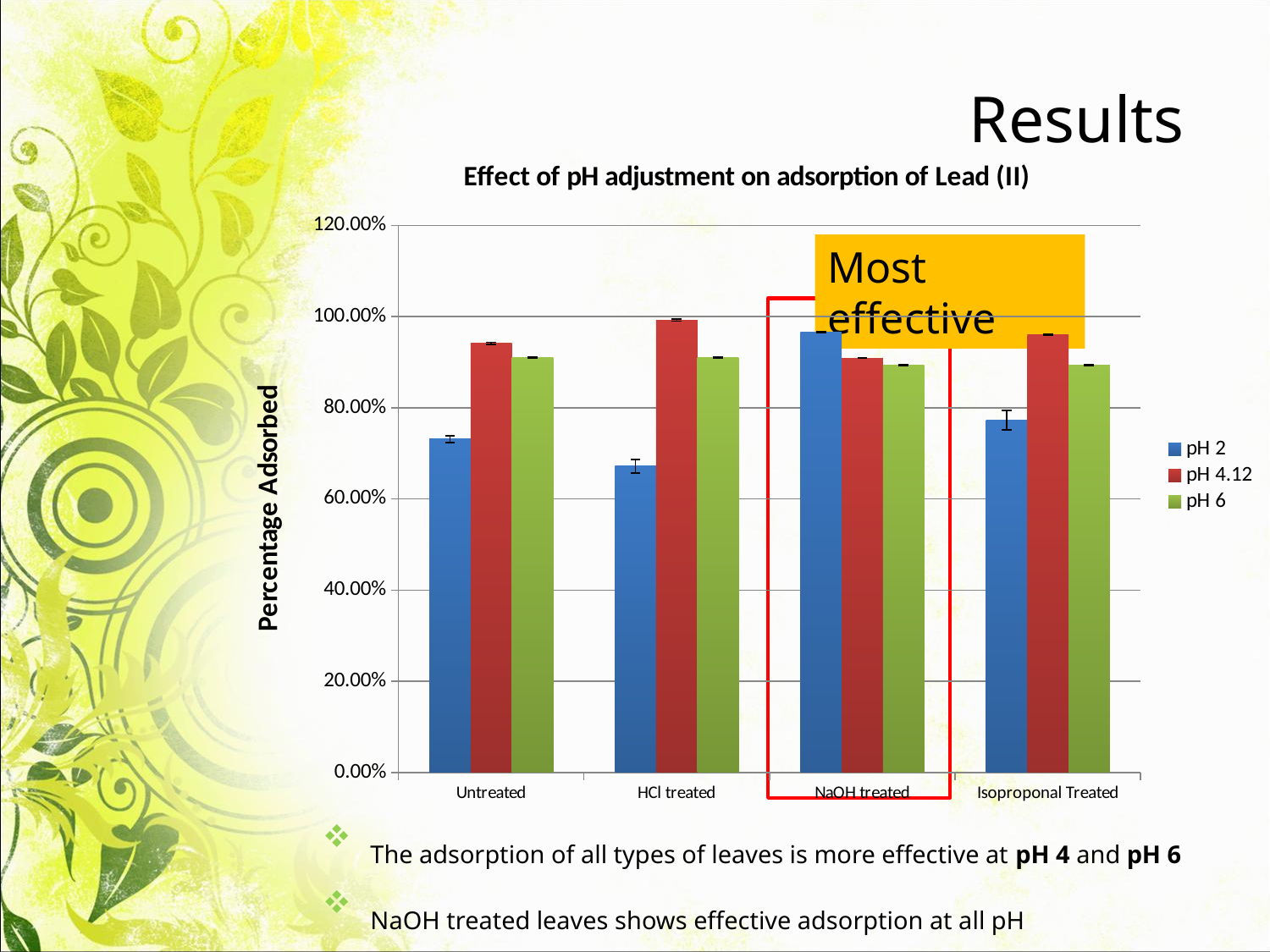
What kind of chart is shown on the slide? bar chart Is the pH 4.12 value for HCl treated greater or less than 80.00%? greater Is the pH 2 value for NaOH treated greater or less than 80.00%? greater How many series does the chart legend list? 3 Is the pH 2 value for HCl treated greater or less than 80.00%? less What is the title of the chart? Effect of pH adjustment on adsorption of Lead (II) Which treatment category has the lowest pH 2 value? HCl treated What is the label of the vertical axis of the chart? Percentage Adsorbed For NaOH treated, which is larger: the pH 2 value or the pH 6 value? pH 2 Which treatment category has the highest pH 2 value? NaOH treated How many treatment categories are shown on the x axis of the chart? 4